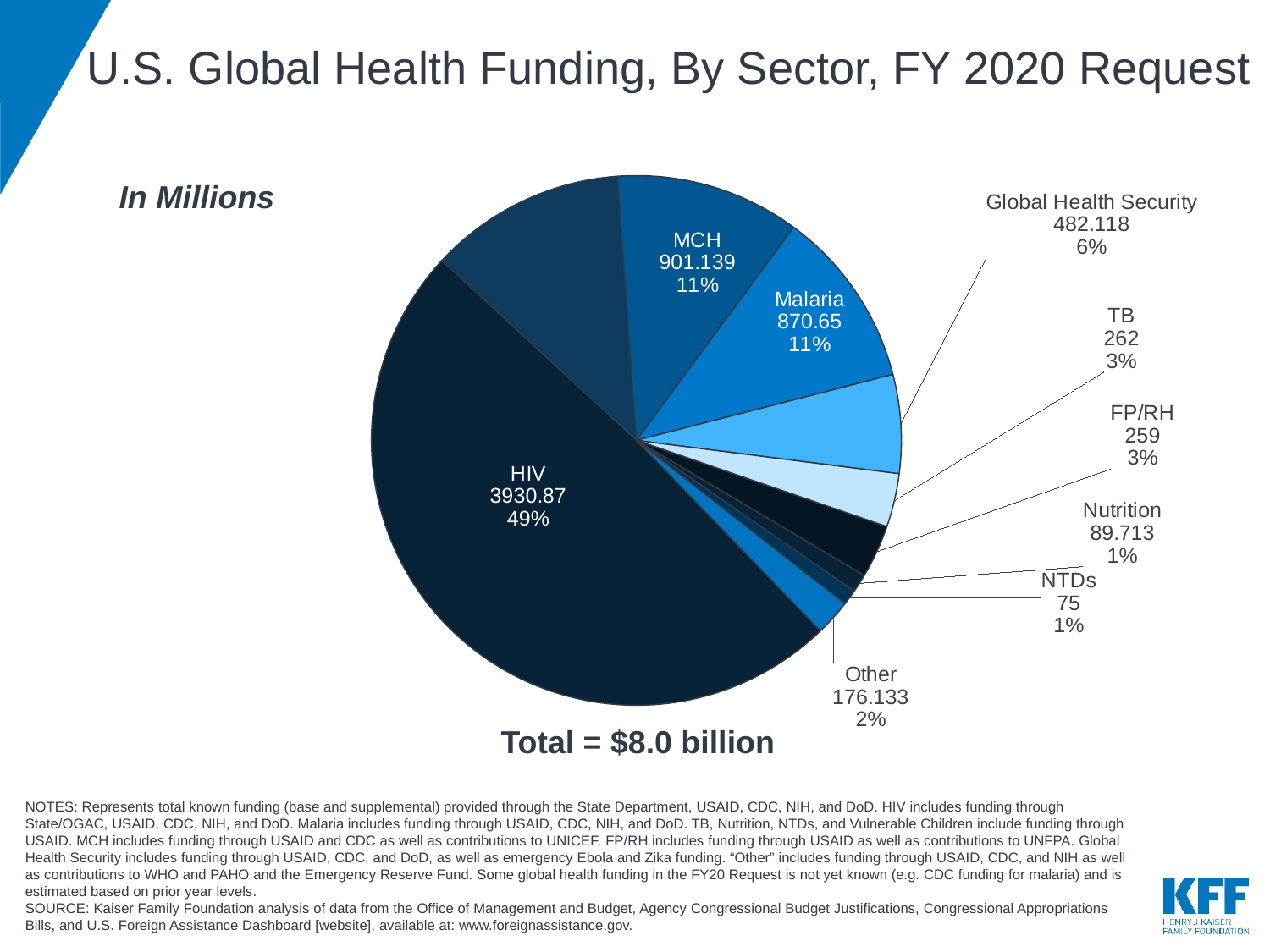
What is the difference between the values for TB and FP/RH? 3 What is the value for Global Health Security? 482.118 What share of the pie does HIV represent? 49% How many sectors are shown in the pie chart? 10 What share of the pie does Malaria represent? 11% What total is stated below the pie chart? $8.0 billion Which sector has the largest slice of the pie? HIV What is the value for Nutrition? 89.713 What type of chart is shown on the slide? Pie chart Which is larger, the value for MCH or the value for Malaria? MCH Which sector has the smallest value in the pie chart? NTDs What is the value for HIV in the pie chart? 3930.87